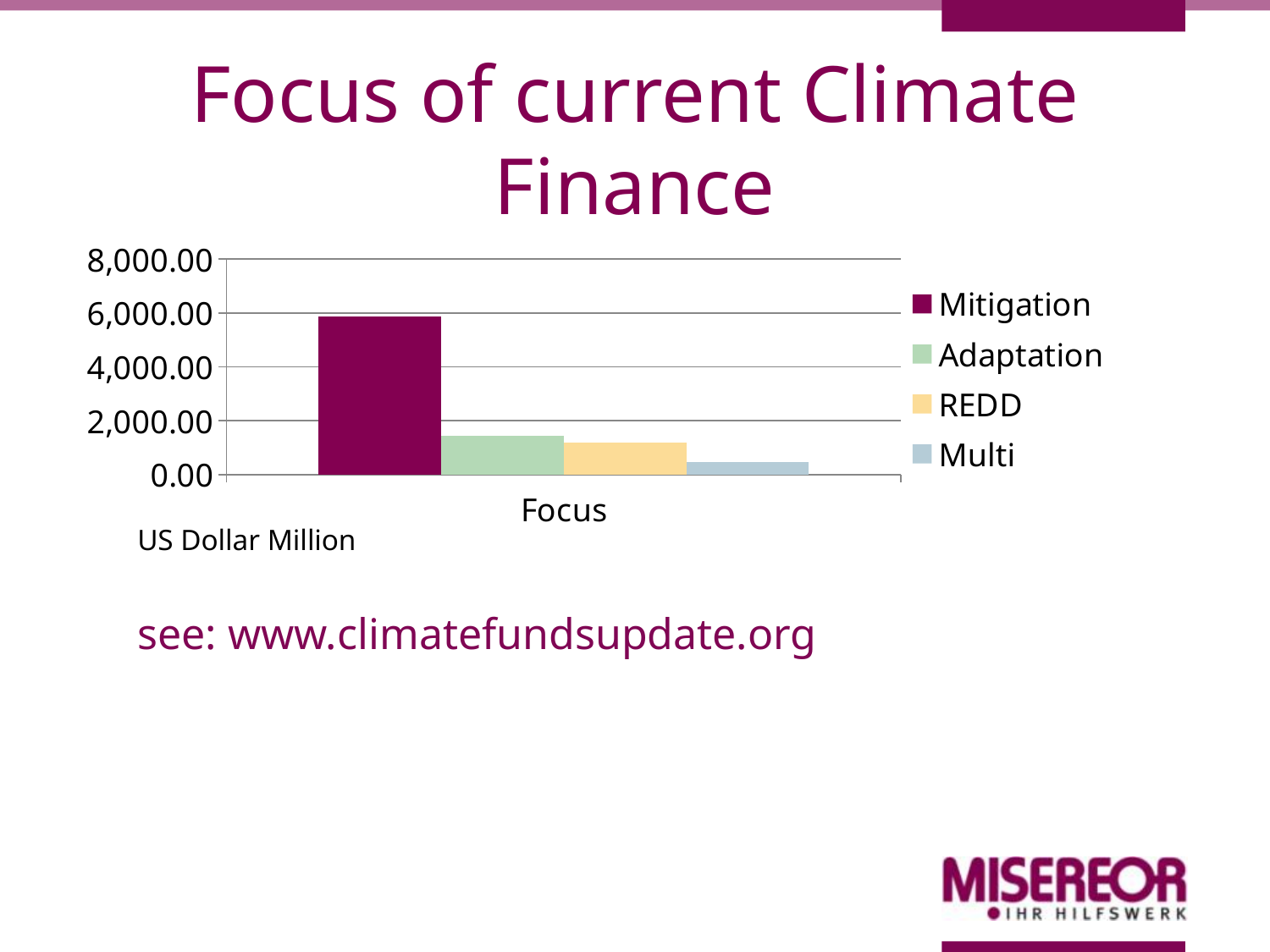
Is the value for REDD greater or less than 4,000.00? less What is the label on the x axis of the chart? Focus Which is larger, the value for Mitigation or the value for Adaptation? Mitigation How many series does the chart's legend list? 4 Is the value for Mitigation greater or less than 4,000.00? greater Which series has the lowest value in the chart? Multi Is the value for Multi greater or less than 2,000.00? less Which is larger, the value for REDD or the value for Multi? REDD What unit is stated below the chart for the values? US Dollar Million What kind of chart is shown on the slide? bar chart Which series has the highest value in the chart? Mitigation